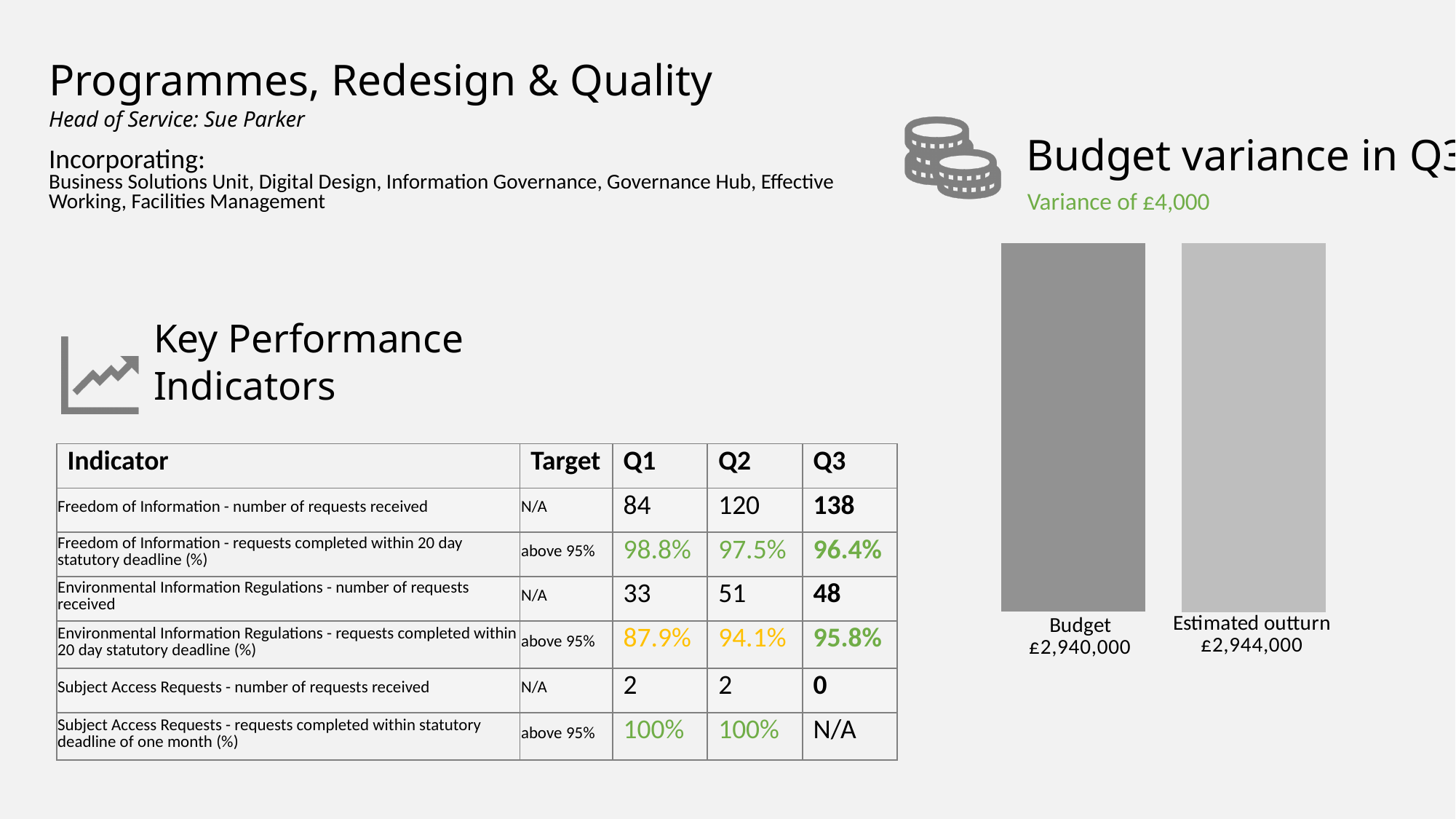
How many bars are plotted in the Budget variance in Q3 chart? 2 In the Budget variance in Q3 chart, what is the value of the Estimated outturn bar? £2,944,000 What kind of chart is shown under the heading "Budget variance in Q3"? bar chart In the Budget variance in Q3 chart, which category has the lowest labelled value? Budget What variance amount is stated above the Budget variance in Q3 chart? Variance of £4,000 In the Budget variance in Q3 chart, what is the value of the Budget bar? £2,940,000 What are the two category labels on the Budget variance in Q3 chart? Budget and Estimated outturn In the Budget variance in Q3 chart, what is the difference between the Estimated outturn and the Budget? £4,000 In the Budget variance in Q3 chart, which bar has the higher value according to its label, Budget or Estimated outturn? Estimated outturn